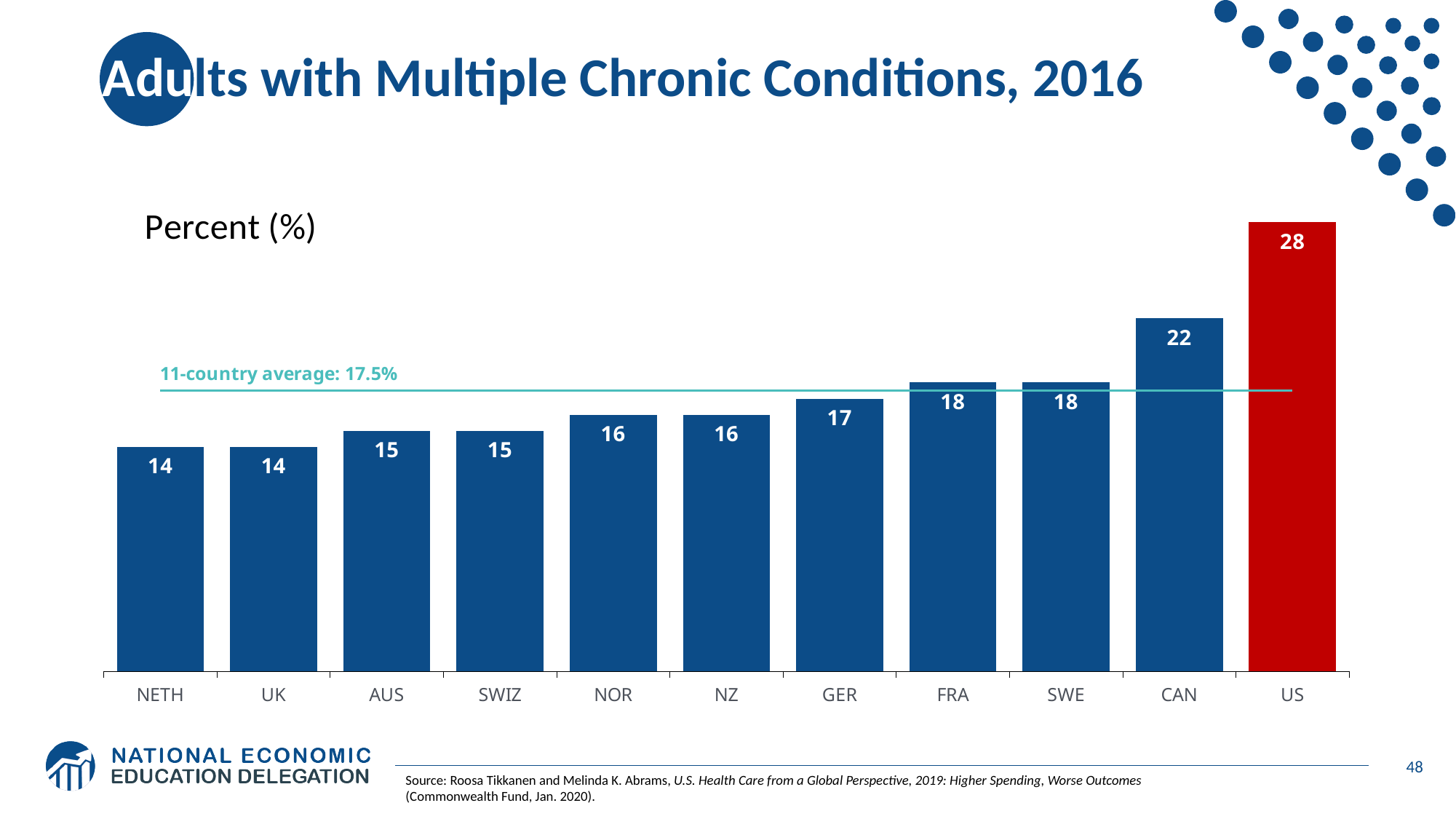
How many countries are shown on the chart? 11 What is the 11-country average shown on the chart? 17.5% What is the value for GER? 17 Which country has the highest value? US What is the difference between the values for the US and CAN? 6 Do the values rise or fall from left to right across the countries? rise What kind of chart is shown on the slide? bar chart Which is larger, the value for CAN or the value for SWE? CAN Which country's bar is coloured red? US What is the value for CAN? 22 What is the value for the US? 28 What is the difference between the values for FRA and NETH? 4